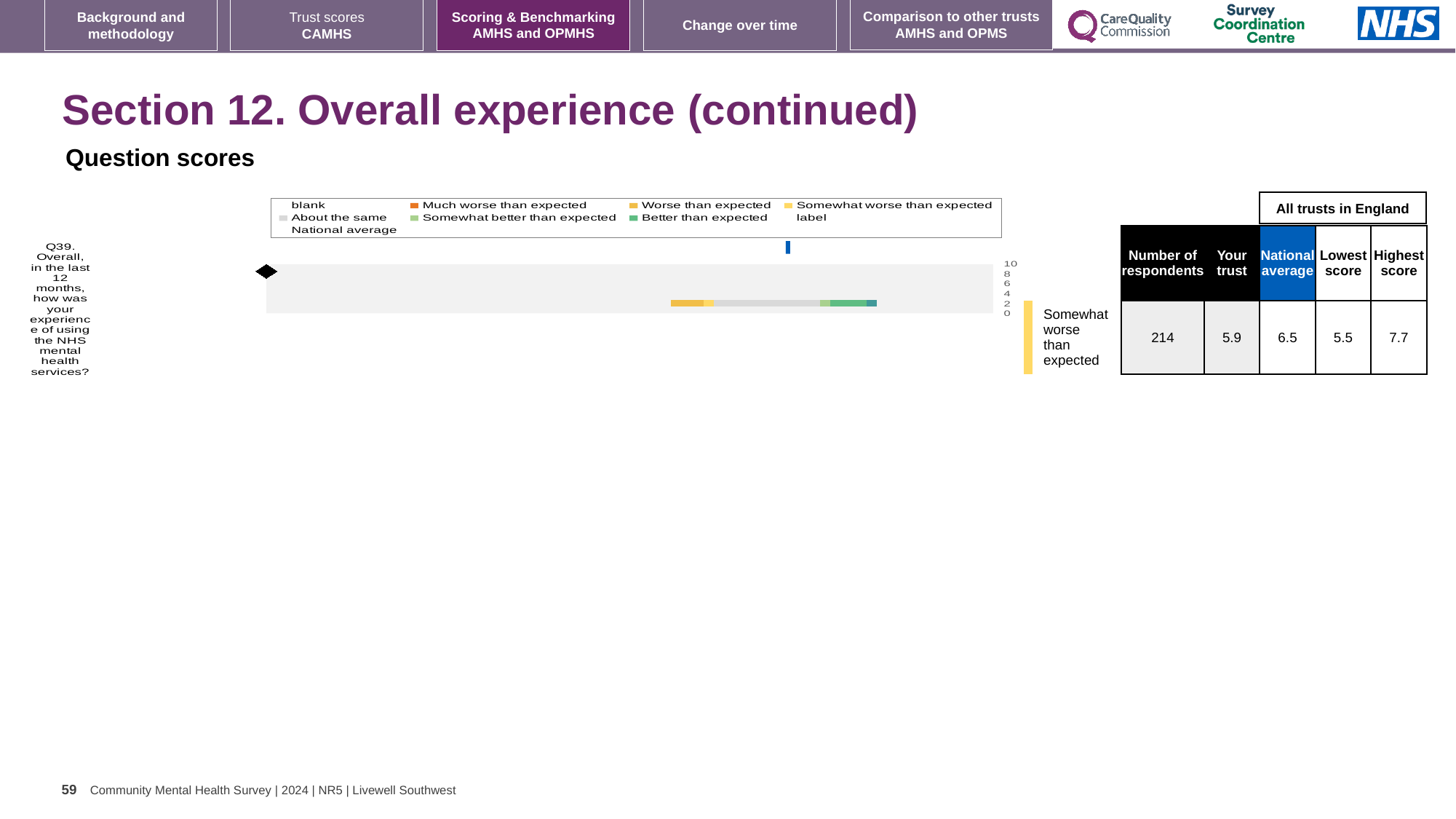
What kind of chart is used to show the Q39 question score? bar chart Which benchmark category is the trust's Q39 score placed in? Somewhat worse than expected How many questions are plotted on the chart? 1 What is the highest score among all trusts in England for Q39? 7.7 What is the difference between the highest and lowest scores for Q39? 2.2 Which is larger for Q39, the 'Your trust' score or the national average? National average What is the national average score for Q39? 6.5 What is the difference between the national average and the 'Your trust' score for Q39? 0.6 What is the lowest score among all trusts in England for Q39? 5.5 What is the number of respondents for Q39? 214 What is the 'Your trust' score for Q39? 5.9 What is the maximum value shown on the chart's score axis? 10